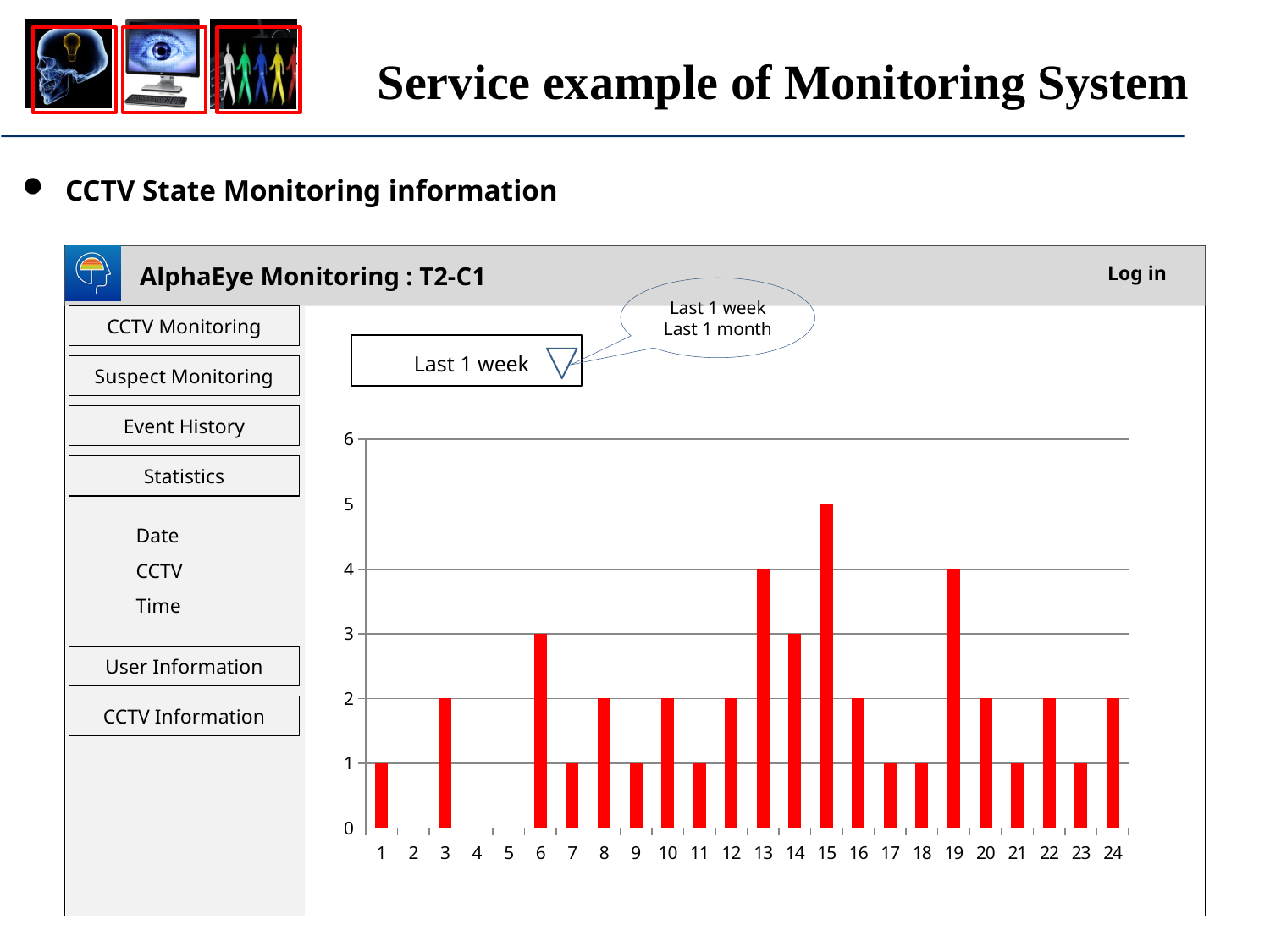
What is the difference between the values for category 15 and category 14? 2 How many categories are shown on the x axis of the chart? 24 What is the value for category 15? 5 What kind of chart is shown on the slide? bar chart What is the value for category 13? 4 Which category has the highest bar in the chart? 15 What is the value for category 1? 1 What is the value for category 6? 3 What colour are the bars in the chart? red What is the highest value shown on the y axis of the chart? 6 Which is larger, the value for category 19 or the value for category 20? 19 Is the value for category 13 greater or less than 3? greater